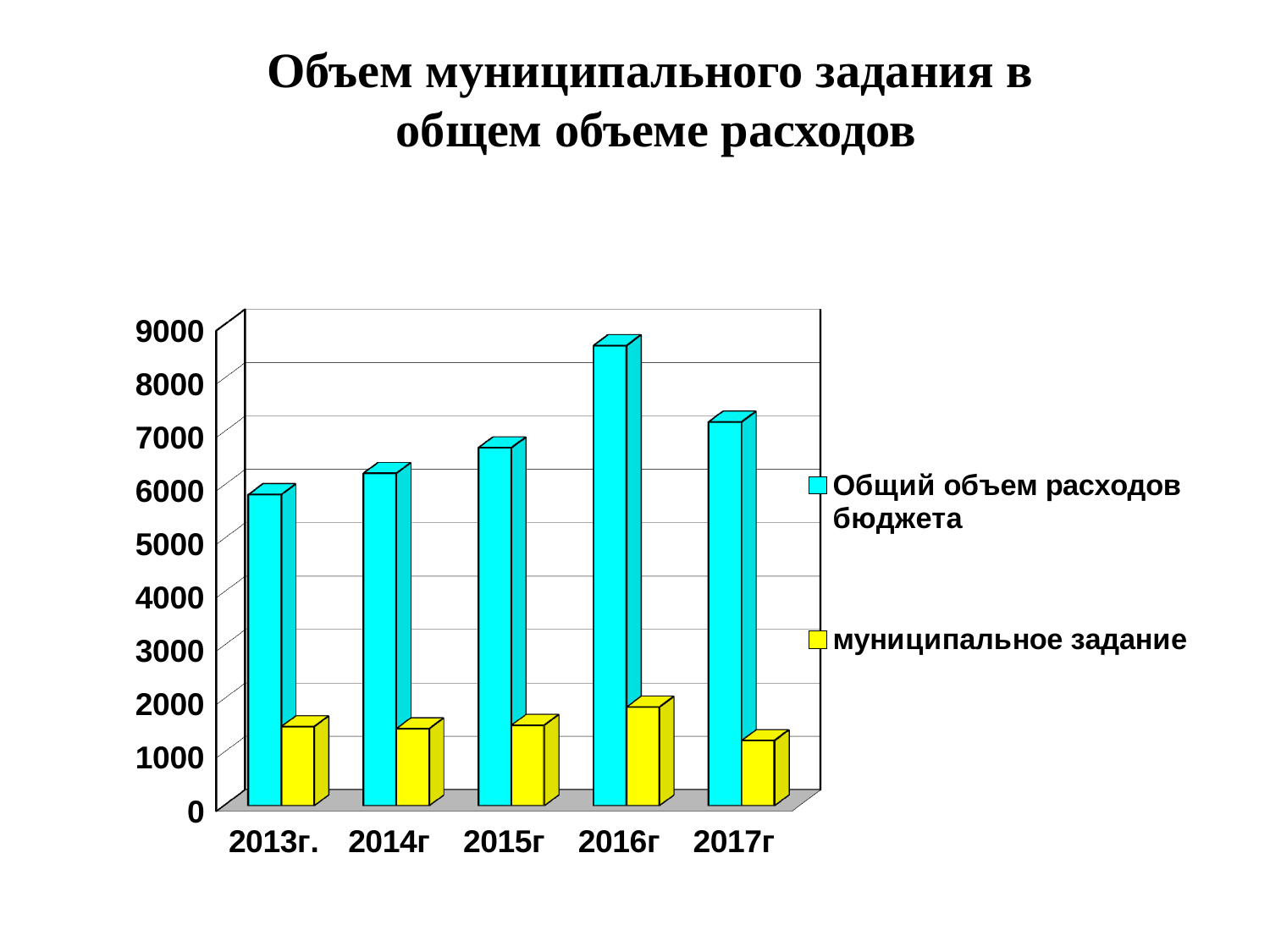
How many years are shown on the x axis of the chart? 5 Which is larger: "Общий объем расходов бюджета" in 2017г or in 2015г? 2017г How many series does the chart legend list? 2 In which year is the value for "Общий объем расходов бюджета" highest? 2016г What kind of chart is shown on the slide? bar chart In which year is the value for "муниципальное задание" highest? 2016г In which year is the value for "Общий объем расходов бюджета" lowest? 2013г. Is the value for "Общий объем расходов бюджета" in 2013г. greater or less than 6000? less What colour are the bars for "муниципальное задание"? yellow Is the value for "муниципальное задание" in 2016г greater or less than 2000? less Is the value for "Общий объем расходов бюджета" in 2016г greater or less than 8000? greater In which year is the value for "муниципальное задание" lowest? 2017г